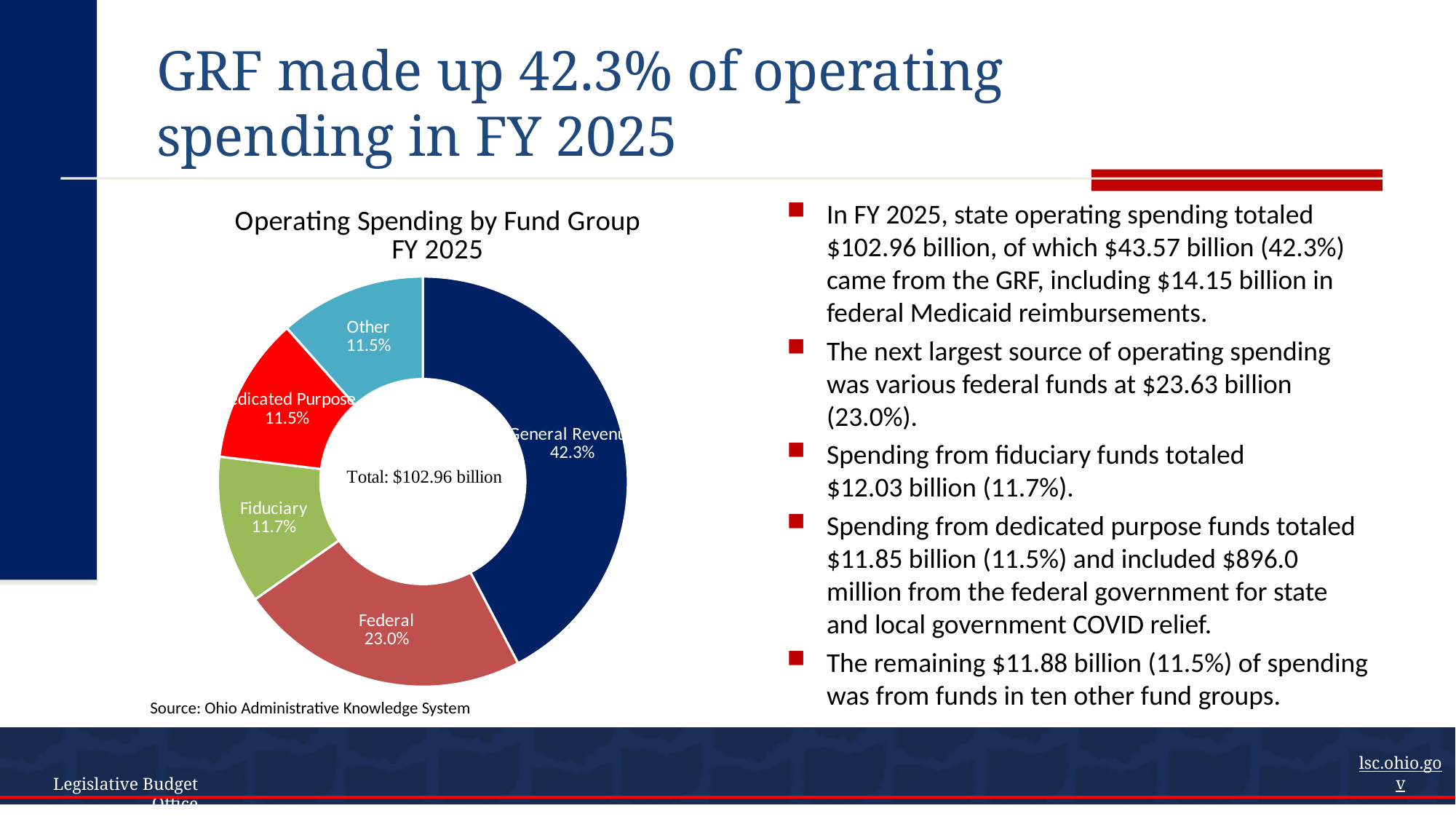
What is the title of the chart? Operating Spending by Fund Group FY 2025 Which is larger, the Federal share or the Fiduciary share? Federal What share of operating spending does the Federal slice represent? 23.0% What share of operating spending does the Fiduciary slice represent? 11.7% How many fund groups are shown in the chart? 5 What is the difference in percentage points between the Fiduciary share and the Other share? 0.2 What share of operating spending does the General Revenue slice represent? 42.3% What total is printed in the center of the chart? Total: $102.96 billion Which fund group has the largest share of operating spending? General Revenue What is the difference in percentage points between the General Revenue share and the Federal share? 19.3 What kind of chart is shown on the slide? Pie chart (donut)